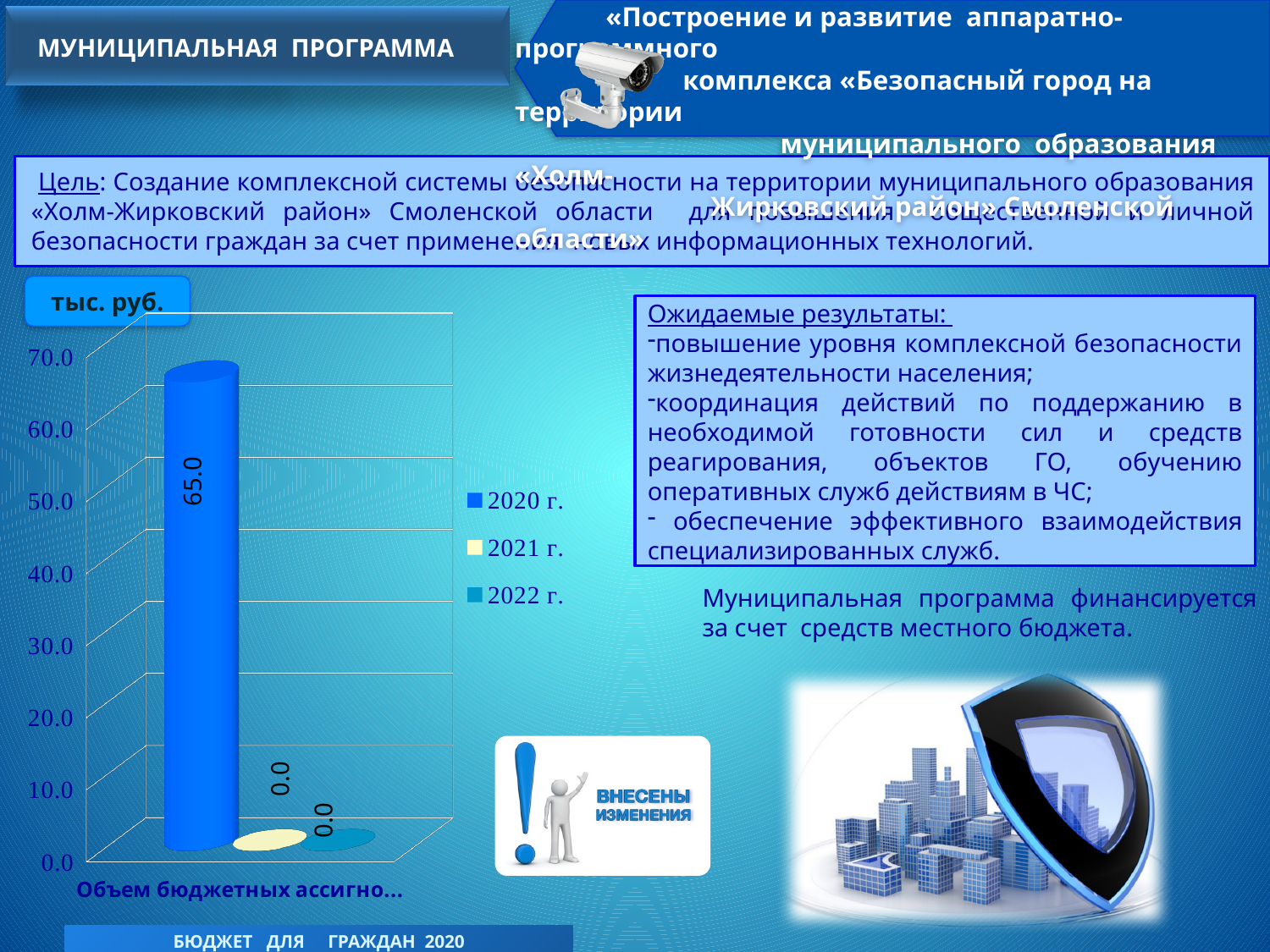
How many series does the chart legend list? 3 What is the value for the 2021 г. series in the chart? 0.0 What is the value for the 2022 г. series in the chart? 0.0 What is the highest value shown on the chart's vertical axis? 70.0 What kind of chart is shown on the slide? bar chart Which series has the highest value in the chart? 2020 г. Is the value for 2020 г. greater or less than 70.0? less What is the value for the 2020 г. series in the chart? 65.0 Is the value for 2020 г. greater or less than 60.0? greater Which is larger, the value for 2020 г. or the value for 2022 г.? 2020 г. What is the difference between the values for 2020 г. and 2021 г.? 65.0 What unit of measurement is shown above the chart? тыс. руб.